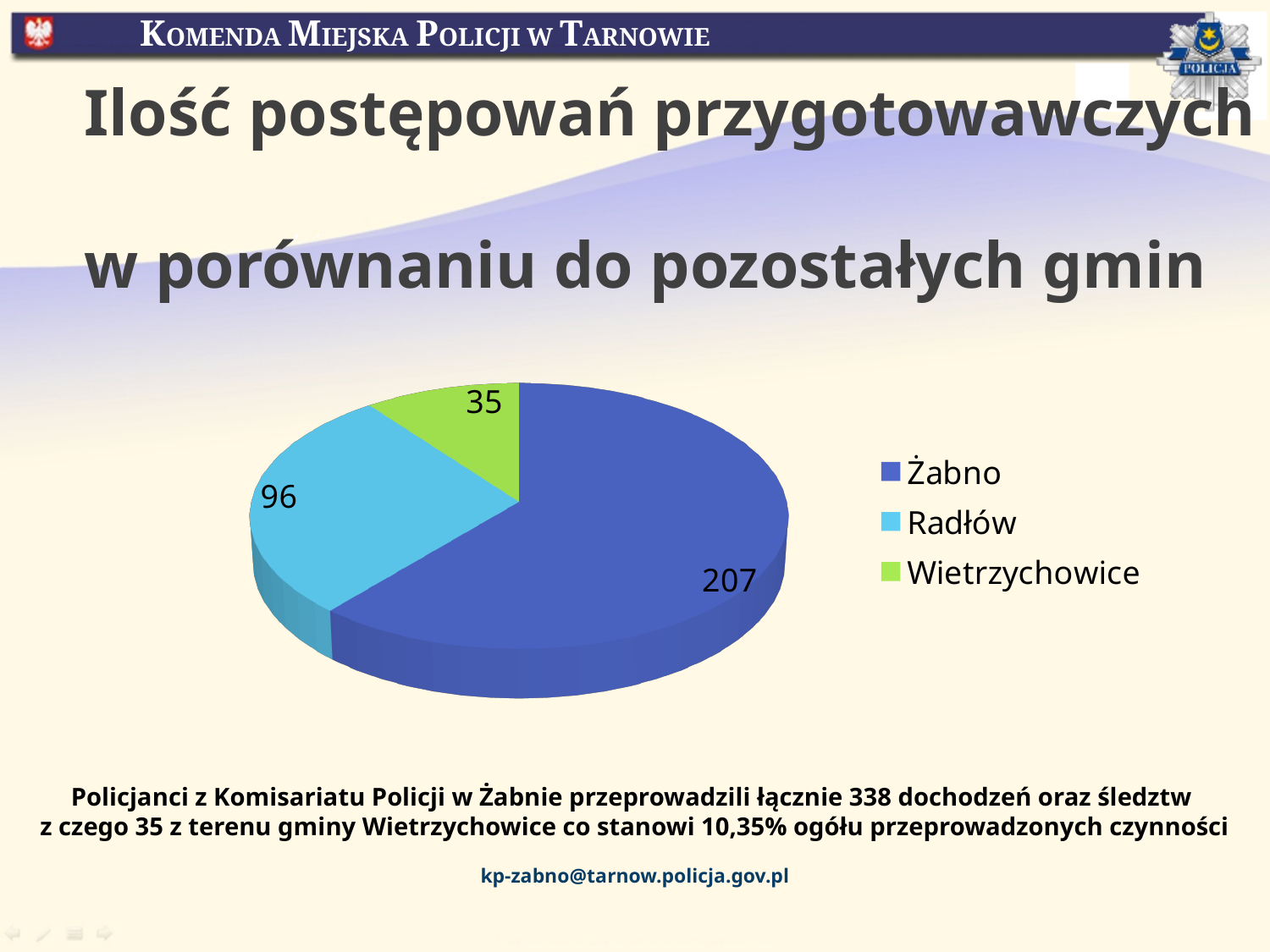
What is the difference between the values for Radłów and Wietrzychowice? 61 What is the value for Żabno in the pie chart? 207 What is the value for Wietrzychowice in the pie chart? 35 How many categories does the pie chart show? 3 Which category has the smallest slice in the pie chart? Wietrzychowice What is the value for Radłów in the pie chart? 96 Which is larger, the value for Radłów or the value for Wietrzychowice? Radłów Which colour represents Wietrzychowice in the pie chart? green Which category has the largest slice in the pie chart? Żabno What is the total of all slices in the pie chart? 338 What is the difference between the values for Żabno and Radłów? 111 What type of chart is shown on the slide? pie chart